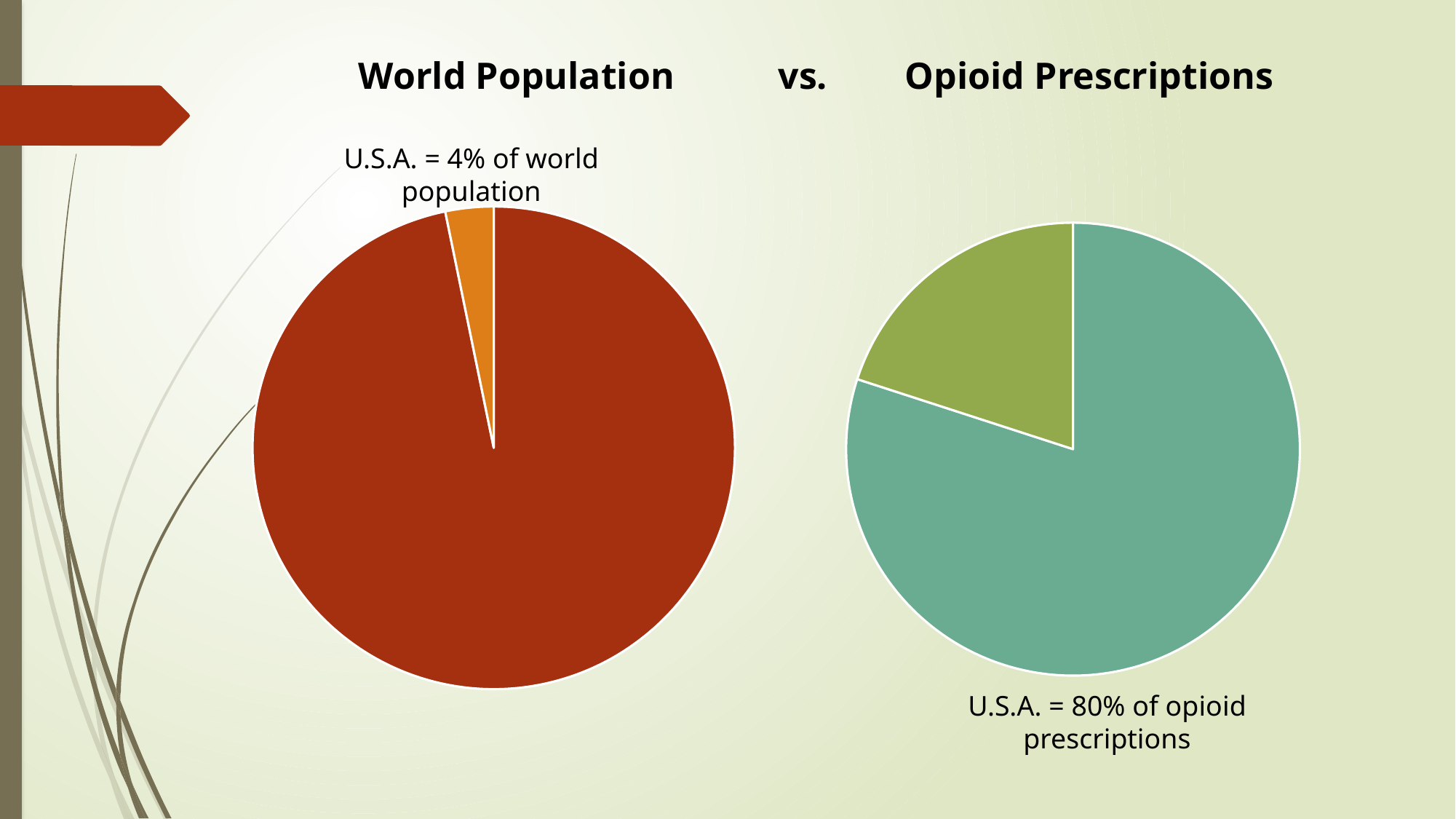
Is the U.S.A. share larger in the World Population chart or in the Opioid Prescriptions chart? Opioid Prescriptions How many slices does the Opioid Prescriptions pie chart have? 2 How many slices does the World Population pie chart have? 2 In the World Population pie chart, what colour is the U.S.A. slice? Orange What is the difference between the U.S.A. share of opioid prescriptions and the U.S.A. share of world population? 76 percentage points What kind of chart is the World Population chart on the left? Pie chart In the World Population pie chart, is the U.S.A. slice the largest or the smallest slice? Smallest What are the titles of the two pie charts on the slide? World Population and Opioid Prescriptions In the Opioid Prescriptions pie chart, is the U.S.A. slice the largest or the smallest slice? Largest What kind of chart is the Opioid Prescriptions chart on the right? Pie chart In the World Population pie chart, what share of the world population does the U.S.A. account for? 4% In the Opioid Prescriptions pie chart, what share of opioid prescriptions does the U.S.A. account for? 80%